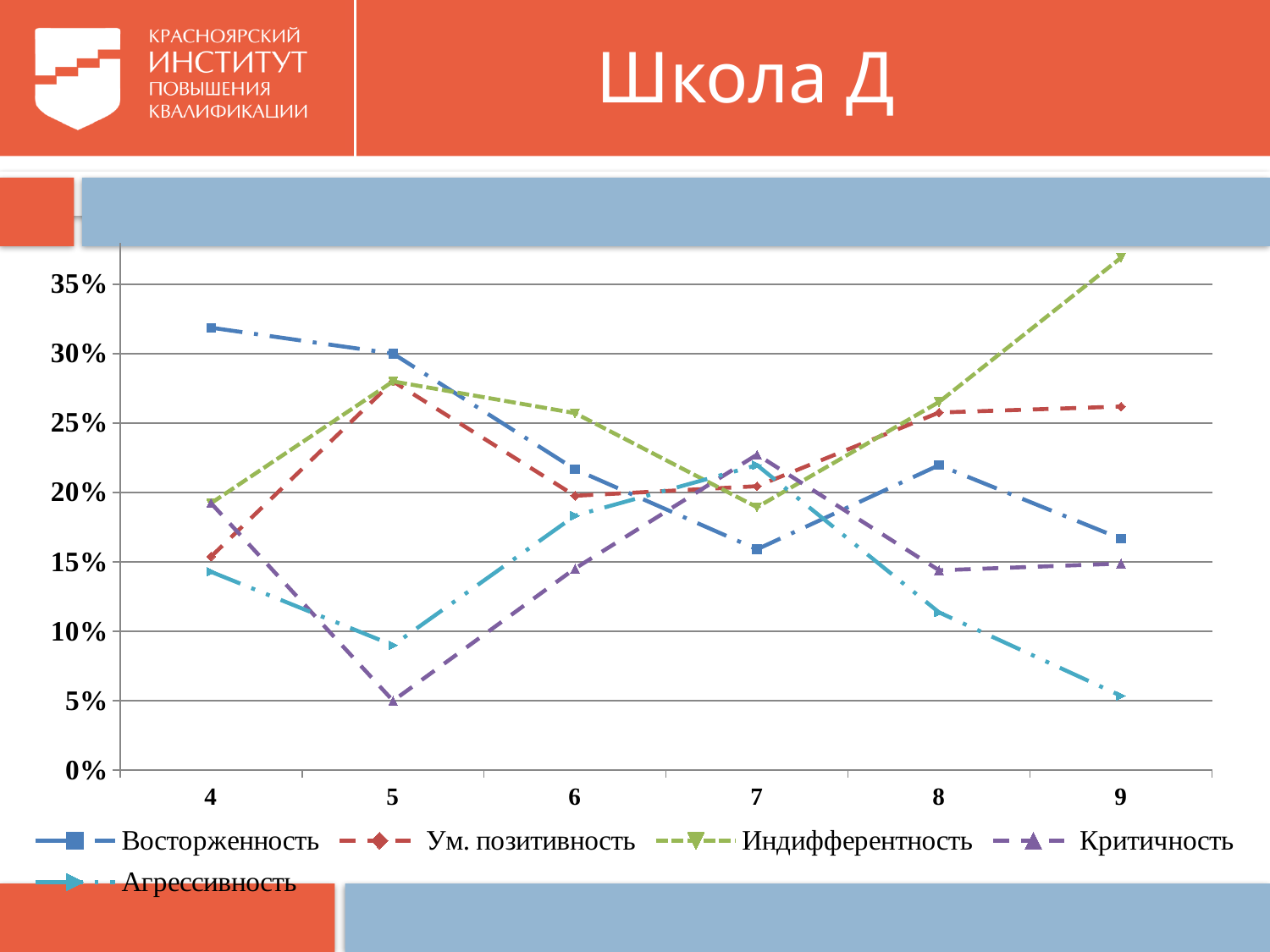
Which series has the lowest value at 5? Критичность Is the value for Индифферентность at 9 greater or less than 35%? greater What is the title of the slide containing the chart? Школа Д Does the Индифферентность line rise or fall from 7 to 9? rise Which series has the highest value at 9? Индифферентность Is the value for Агрессивность at 9 greater or less than 10%? less How many series does the legend list? 5 How many points are there along the x axis? 6 Which series has the highest value at 4? Восторженность Is the value for Восторженность at 4 greater or less than 30%? greater What kind of chart is shown on the slide? line chart